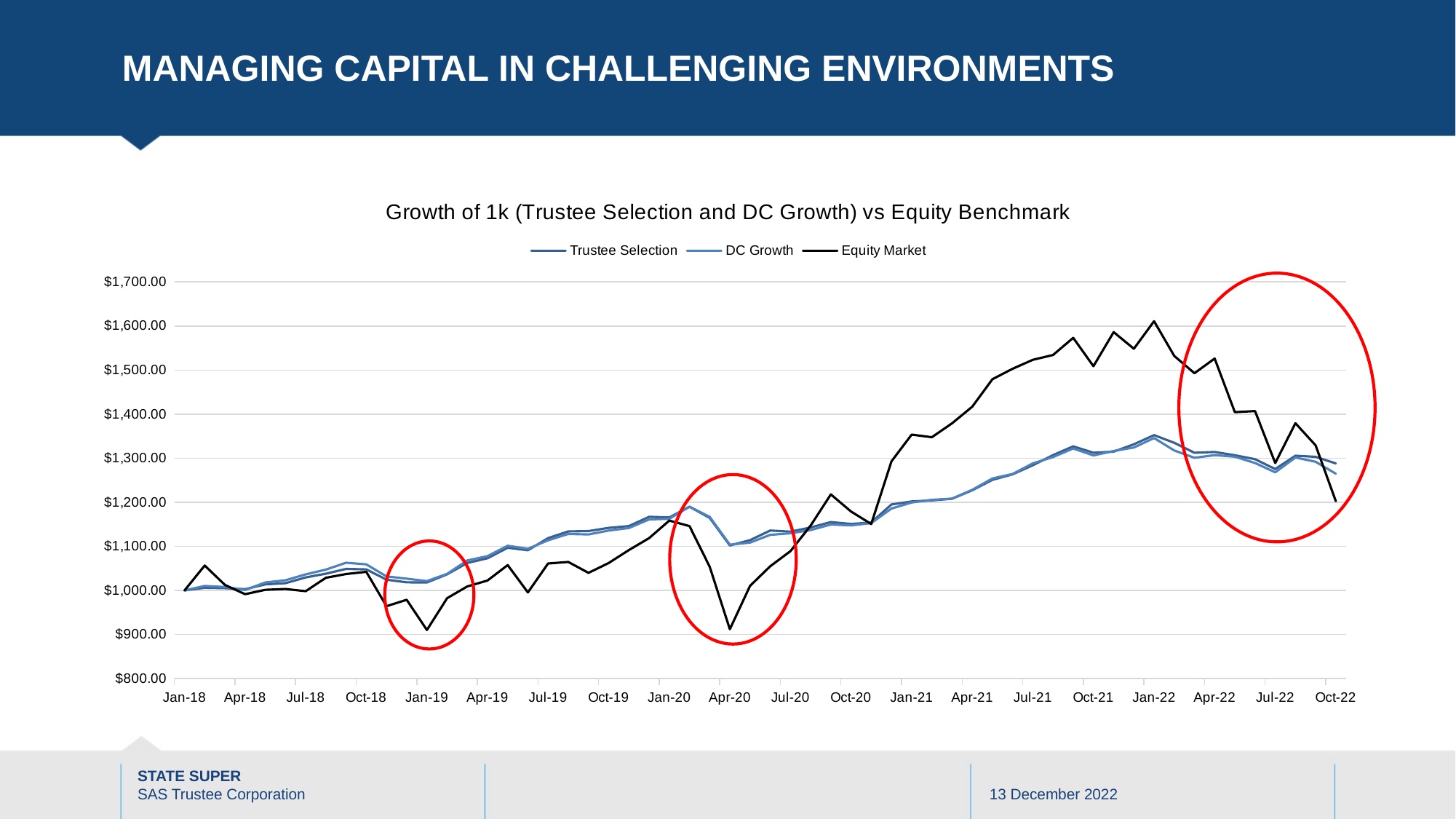
Which series is drawn in black? Equity Market Does the Equity Market line rise or fall from Jan-22 to Oct-22? Fall What kind of chart is shown on the slide? Line chart Is the value for Equity Market at Apr-20 greater or less than $1,000.00? less Is the value for Trustee Selection at Jan-22 greater or less than $1,300.00? greater How many series does the legend list? 3 Is the value for Equity Market at Jan-21 greater or less than $1,300.00? greater At Oct-21, which is larger: Equity Market or Trustee Selection? Equity Market At Apr-20, which is larger: DC Growth or Equity Market? DC Growth What is the title of the chart? Growth of 1k (Trustee Selection and DC Growth) vs Equity Benchmark How many date labels are shown on the x axis? 20